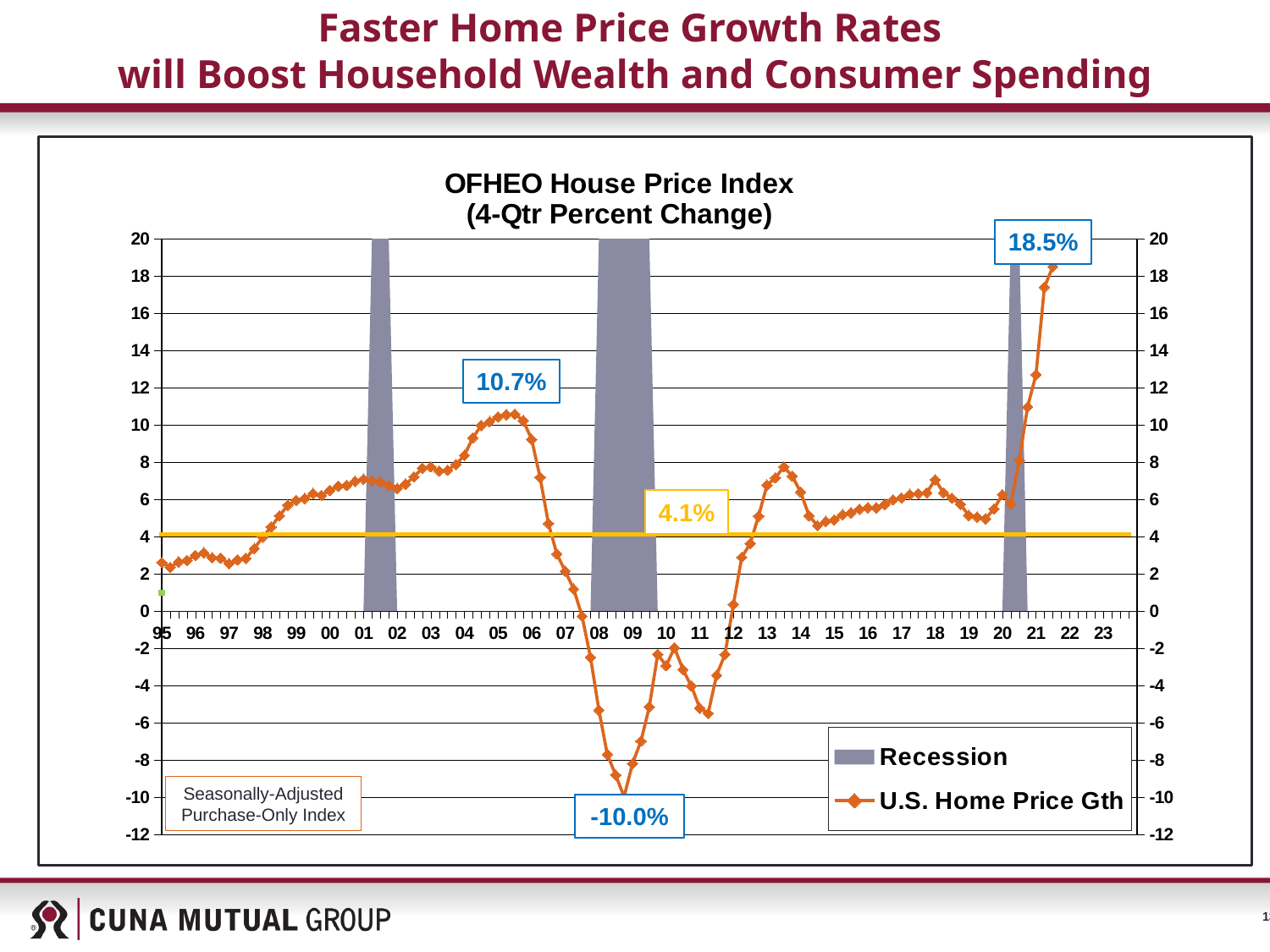
What is the title of the chart? OFHEO House Price Index (4-Qtr Percent Change) What is the lowest labeled value of U.S. Home Price Gth on the chart? -10.0% What kind of chart is shown on the slide? Line chart What is the highest labeled value of U.S. Home Price Gth on the chart? 18.5% What do the grey shaded areas on the chart represent? Recession What labeled value does the home price growth line reach at its peak around 2005? 10.7% Does the U.S. Home Price Gth line rise or fall between 2019 and 2021? Rise What is the difference between the 18.5% peak and the 10.7% peak? 7.8 percentage points Which peak is larger, the one around 2005 or the one around 2021? The one around 2021 Is the value for U.S. Home Price Gth around 2011 greater or less than 0? less How many entries does the chart legend list? 2 What value is labeled on the horizontal yellow reference line? 4.1%